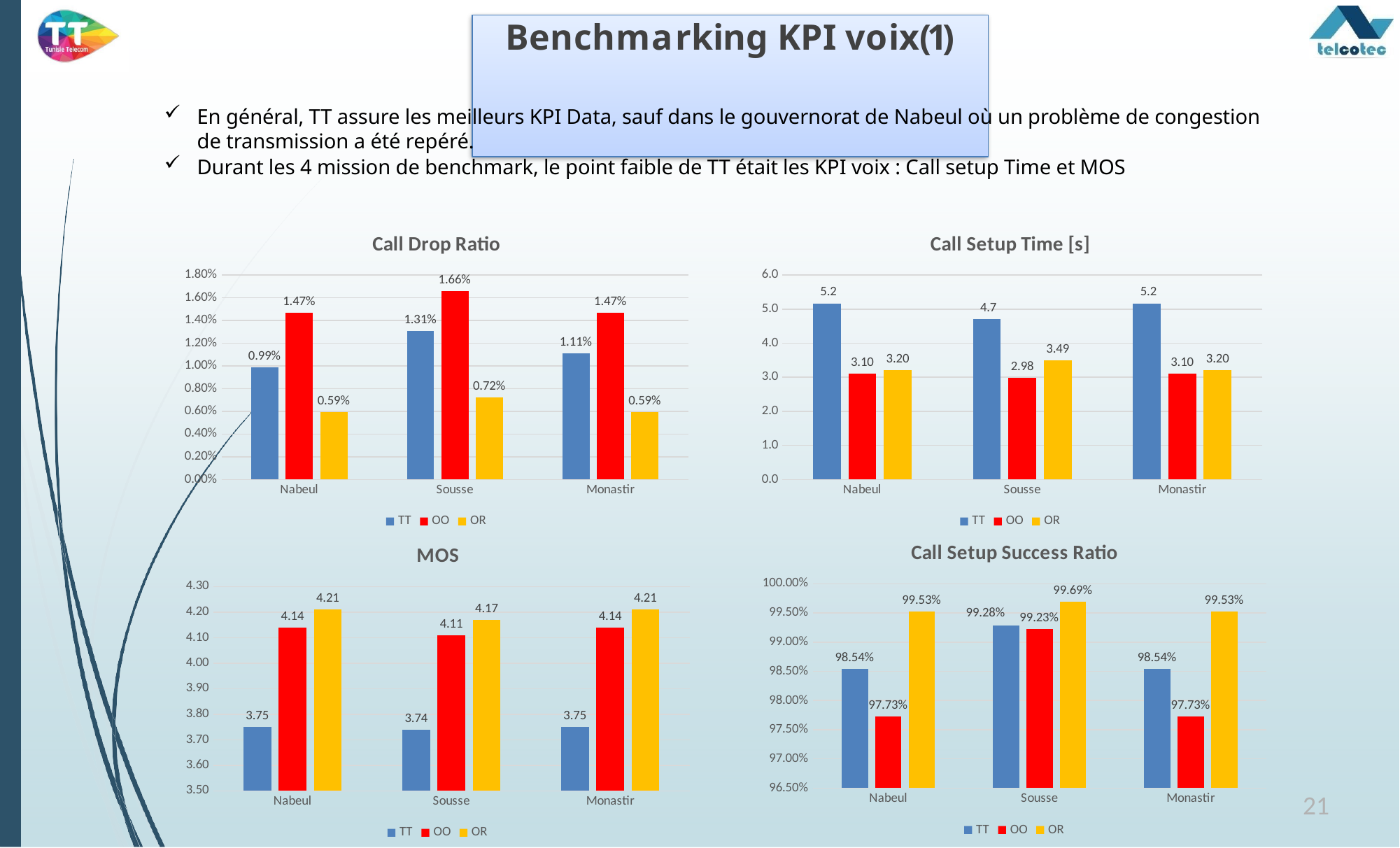
In the MOS chart, which is larger in Monastir: OO or OR? OR How many series does the legend of the Call Drop Ratio chart list? 3 What type of chart is the MOS chart? Bar chart In the Call Setup Success Ratio chart, what is the value for OR in Sousse? 99.69% In the Call Setup Time [s] chart, which series has the highest value in Monastir? TT In the Call Setup Time [s] chart, what is the difference between TT and OO in Nabeul? 2.1 In the MOS chart, is the value for TT in Nabeul greater or less than 4.00? less In the Call Setup Success Ratio chart, which series has the lowest value in Nabeul? OO In the Call Setup Time [s] chart, what is the value for TT in Sousse? 4.7 In the MOS chart, what is the value for OR in Sousse? 4.17 In the Call Drop Ratio chart, what is the value for OO in Sousse? 1.66% In the Call Drop Ratio chart, which series has the lowest value in Nabeul? OR